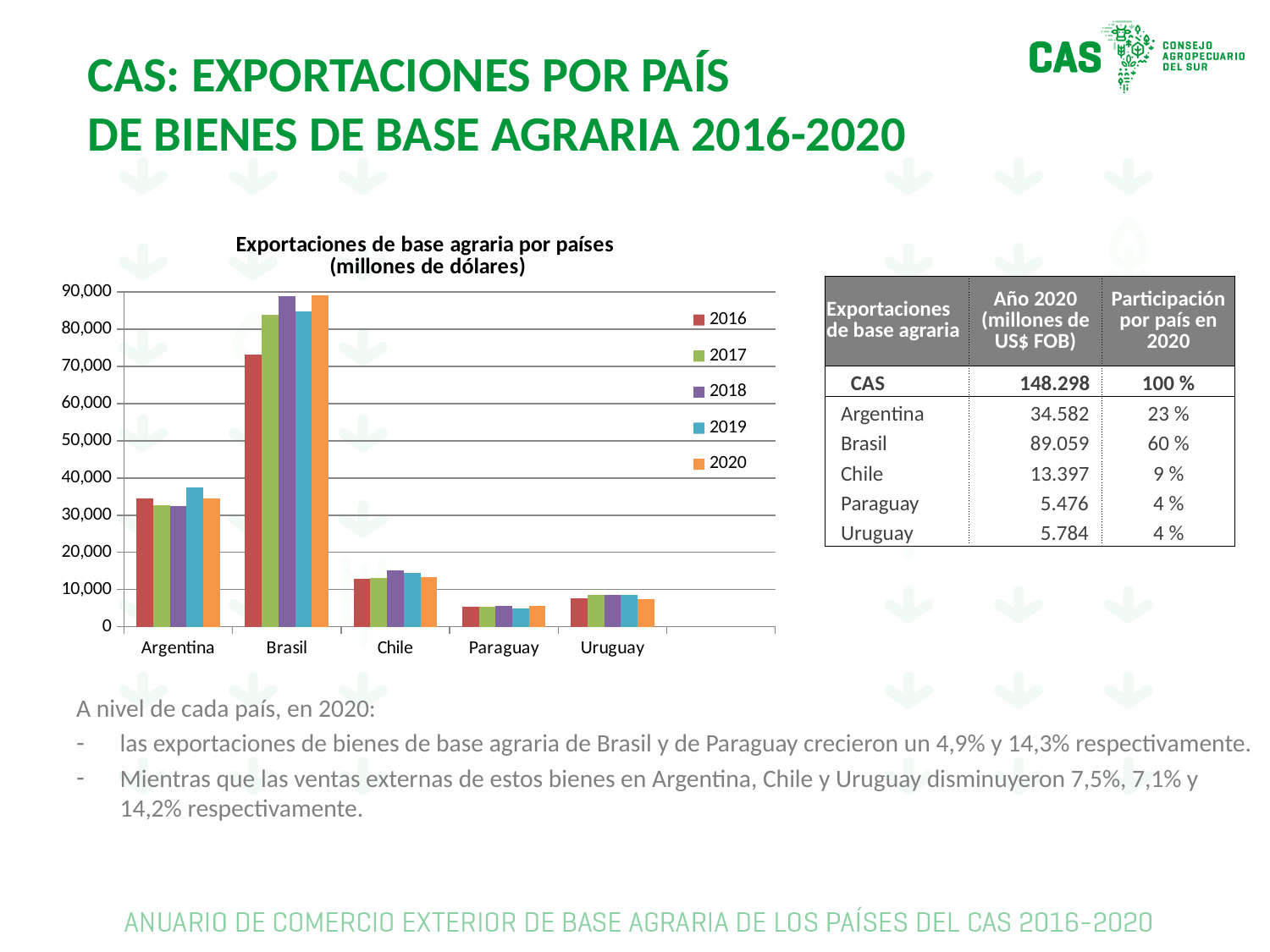
Which country has the lowest exports in 2016 in the chart? Paraguay Did Brasil's exports rise or fall from 2016 to 2017 in the chart? rise How many series does the chart legend list? 5 Which colour represents the year 2020 in the chart legend? orange What kind of chart is shown on the slide? bar chart Which country has the highest exports in 2020 in the chart? Brasil In 2020, which country has larger exports in the chart, Argentina or Chile? Argentina Is the value for Argentina in 2019 greater or less than 30,000? greater What is the title of the chart? Exportaciones de base agraria por países (millones de dólares) How many countries are shown on the x axis of the chart? 5 Is the value for Paraguay in 2020 greater or less than 10,000? less Is the value for Brasil in 2020 greater or less than 80,000? greater